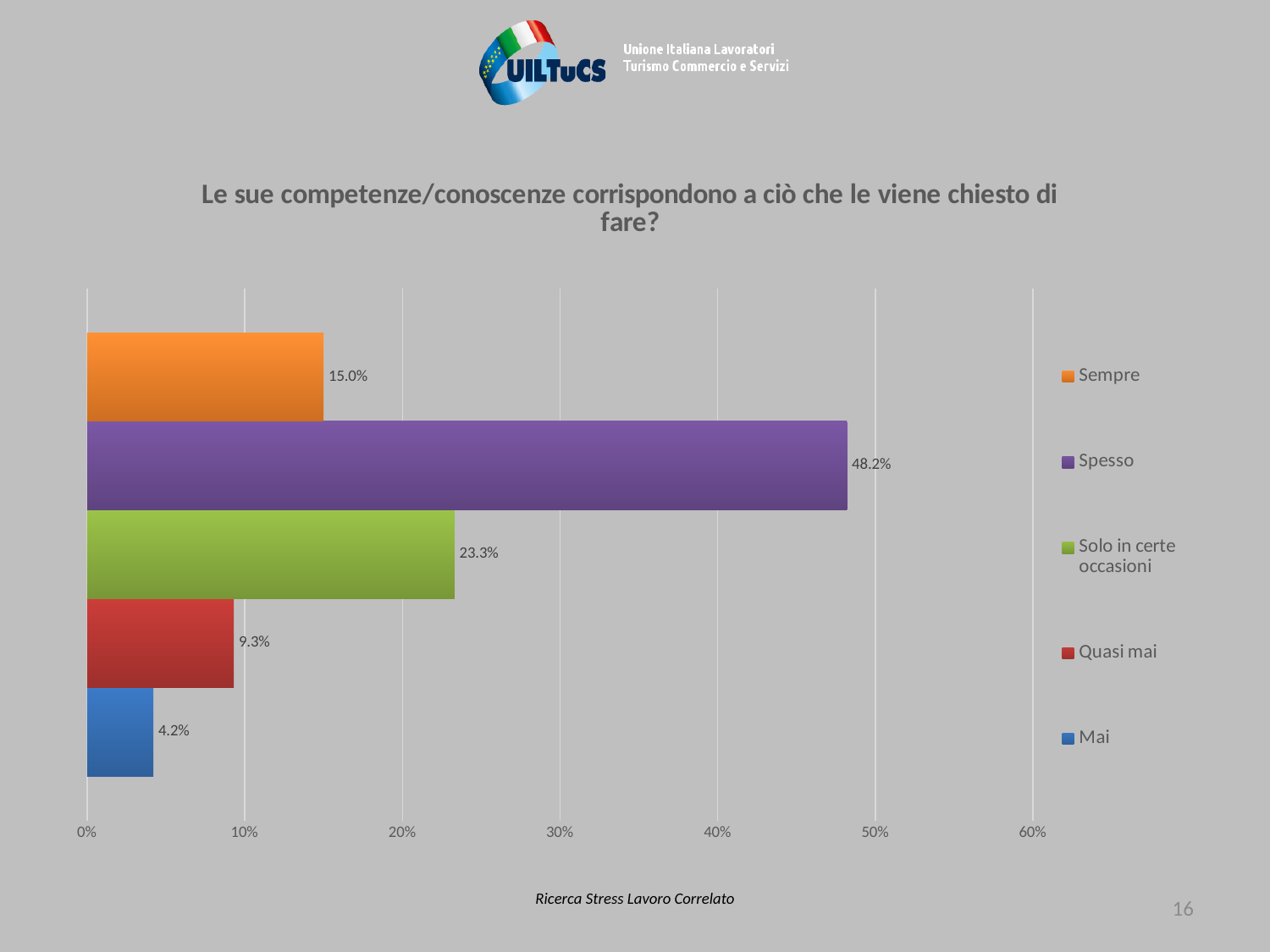
Which is larger, the value for Sempre or the value for Quasi mai? Sempre What is the difference between the values for Spesso and Solo in certe occasioni? 24.9% What is the value for Mai? 4.2% What is the value for Solo in certe occasioni? 23.3% Is the value for Solo in certe occasioni greater or less than 20%? greater How many categories are shown in the chart? 5 Which category has the highest value? Spesso What colour is the bar for Quasi mai? Red What kind of chart is shown on the slide? Bar chart What is the value for Spesso? 48.2% What is the value for Sempre? 15.0% Which category has the lowest value? Mai